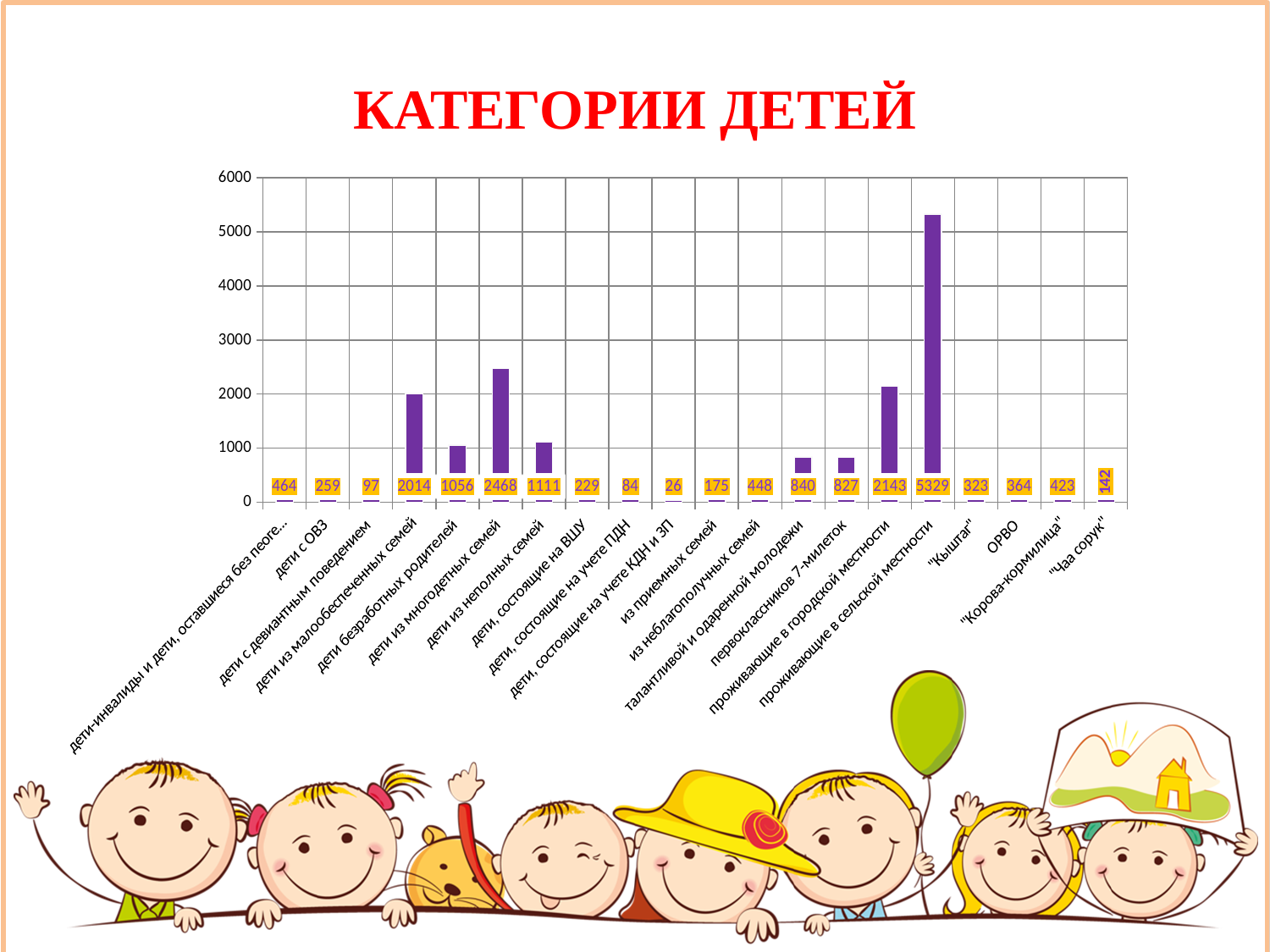
How many categories are shown on the chart? 20 What is the value for "Чаа сорук"? 142 What is the value for "дети с ОВЗ"? 259 What is the value for "дети из многодетных семей"? 2468 Which category has the highest value? проживающие в сельской местности What type of chart is shown on the slide? bar chart What is the difference between the values for "проживающие в сельской местности" and "проживающие в городской местности"? 3186 Is the value for "дети безработных родителей" greater or less than 1000? greater Which category has the lowest value? дети, состоящие на учете КДН и ЗП What is the value for "проживающие в сельской местности"? 5329 What is the title of the chart? КАТЕГОРИИ ДЕТЕЙ Which is larger: the value for "дети из малообеспеченных семей" or "дети из неполных семей"? дети из малообеспеченных семей